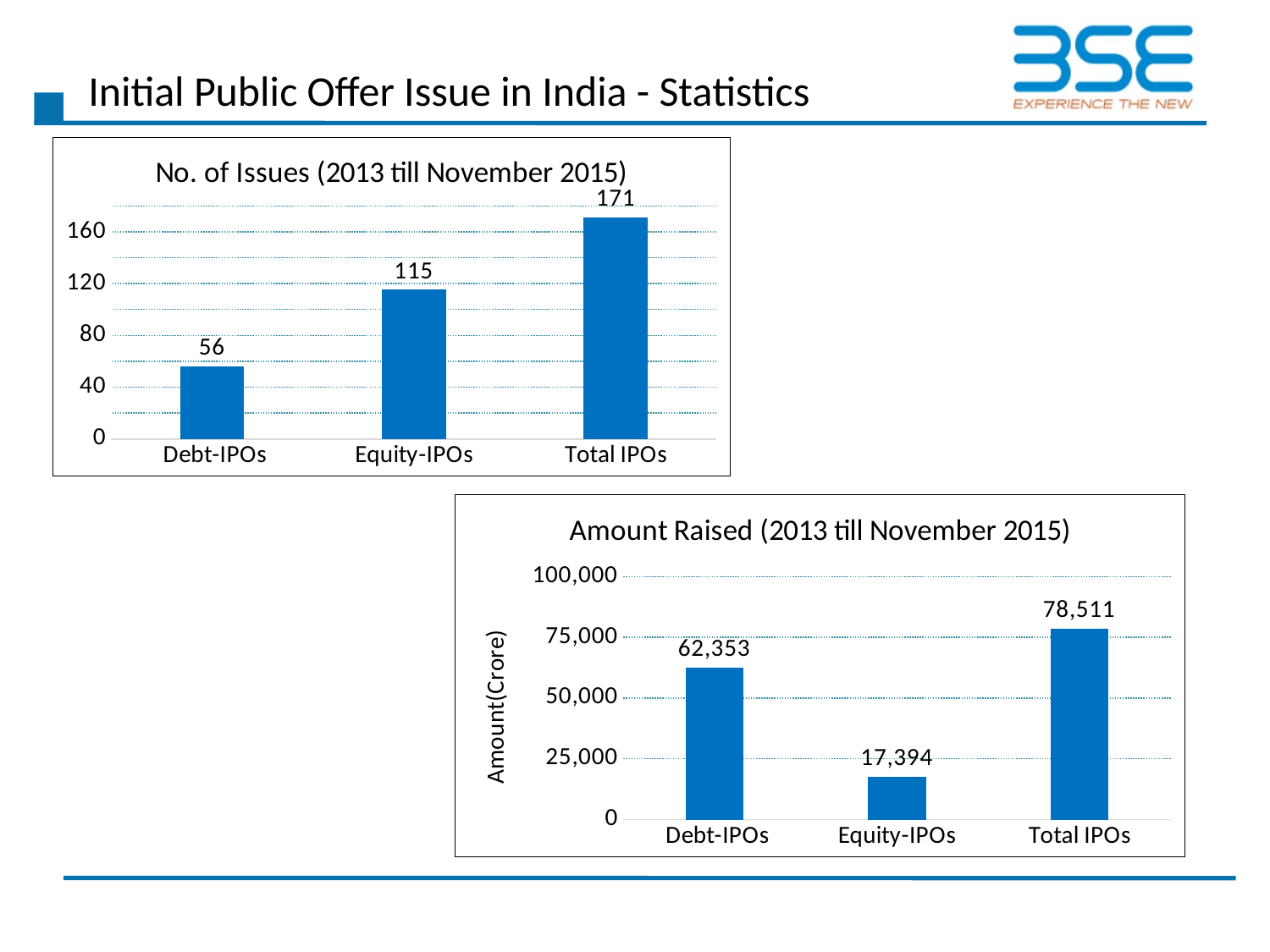
In the 'Amount Raised (2013 till November 2015)' chart, what is the value for Debt-IPOs? 62,353 In the 'Amount Raised (2013 till November 2015)' chart, what is the difference between Total IPOs and Debt-IPOs? 16,158 In the 'No. of Issues (2013 till November 2015)' chart, how many categories are shown on the x axis? 3 In the 'Amount Raised (2013 till November 2015)' chart, what is the value for Equity-IPOs? 17,394 What is the y-axis label of the 'Amount Raised (2013 till November 2015)' chart? Amount(Crore) In the 'No. of Issues (2013 till November 2015)' chart, what is the difference between Equity-IPOs and Debt-IPOs? 59 In the 'No. of Issues (2013 till November 2015)' chart, what is the value for Equity-IPOs? 115 In the 'No. of Issues (2013 till November 2015)' chart, which category has the lowest value? Debt-IPOs In the 'No. of Issues (2013 till November 2015)' chart, what is the value for Debt-IPOs? 56 What kind of chart is the 'Amount Raised (2013 till November 2015)' chart? Bar chart In the 'Amount Raised (2013 till November 2015)' chart, which category has the highest value? Total IPOs In the 'Amount Raised (2013 till November 2015)' chart, which is larger, Debt-IPOs or Equity-IPOs? Debt-IPOs